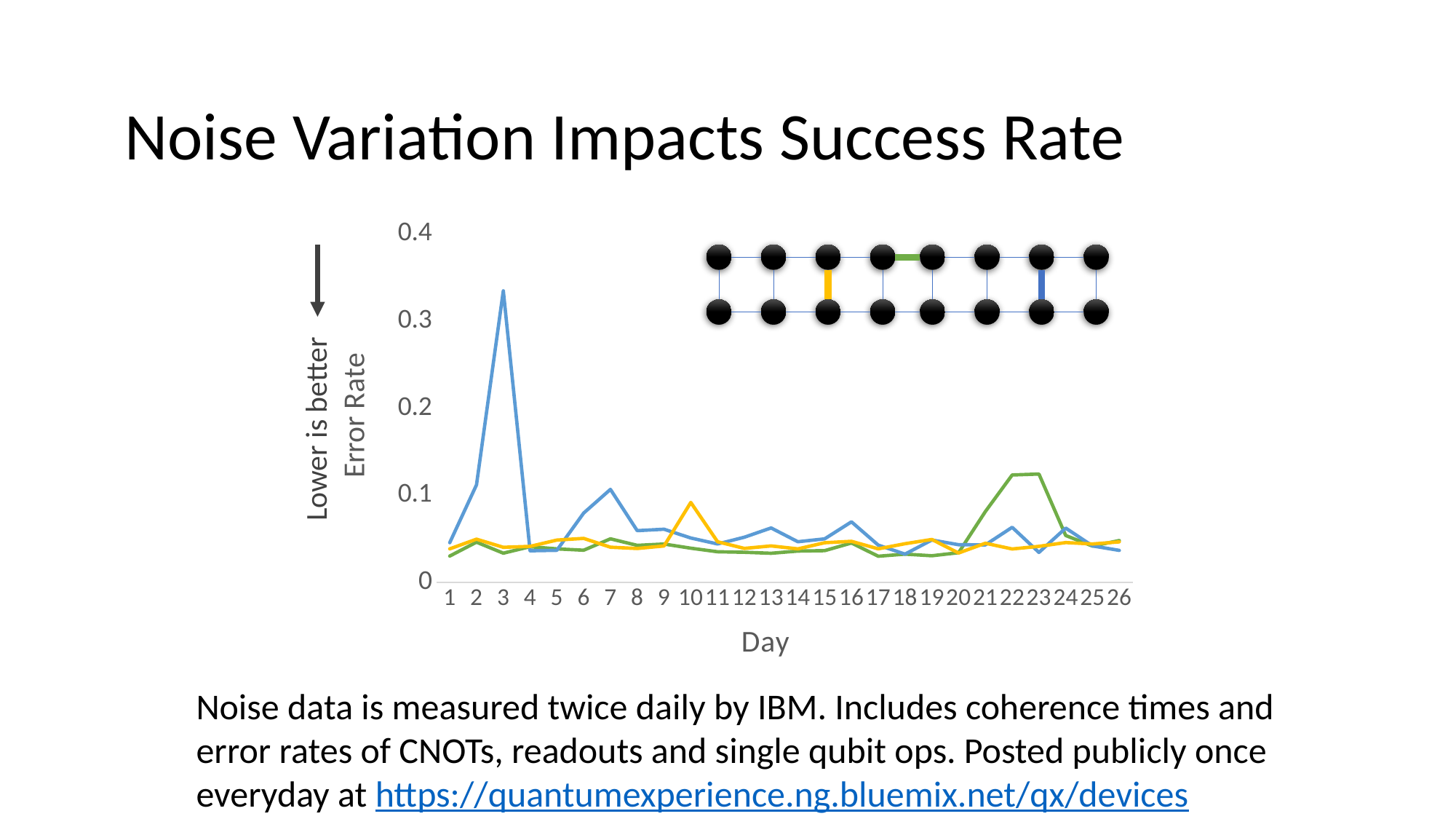
Is the orange line's value on day 10 greater or less than 0.05? greater What kind of chart is shown on the slide? line chart On which day does the blue line reach its highest error rate? 3 How many days are shown along the x axis of the chart? 26 Is the blue line's value on day 3 greater or less than 0.2? greater Is the green line's value on day 22 greater or less than 0.1? greater What is the label of the y axis of the chart? Error Rate What is the label of the x axis of the chart? Day On which day does the orange line reach its highest error rate? 10 On day 22, which line has the higher error rate, the green line or the blue line? green How many lines are plotted on the chart? 3